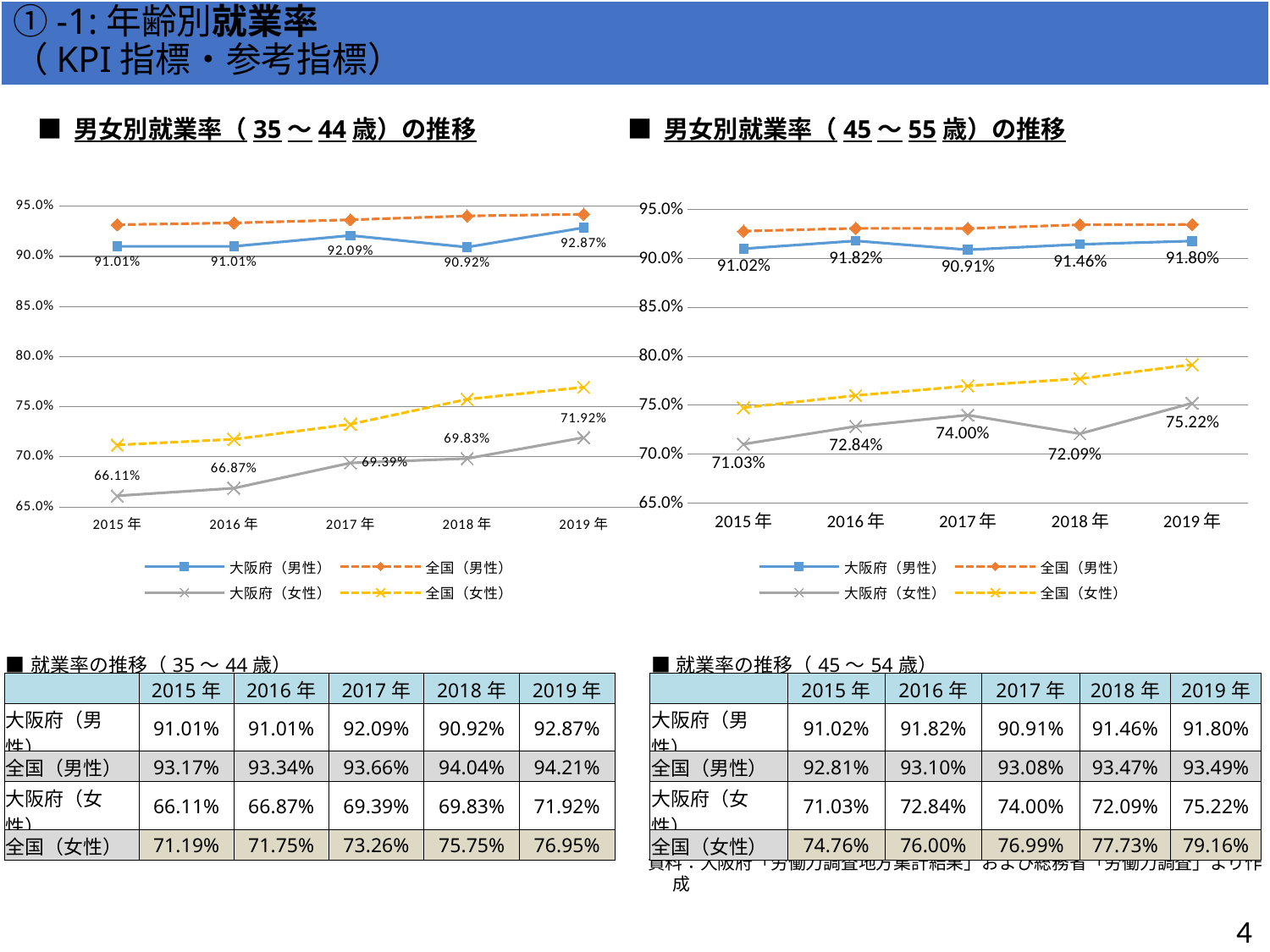
How many series does the legend of the right chart (男女別就業率（45～55歳）の推移) list? 4 In the left chart (男女別就業率（35～44歳）の推移), what is the difference between the 大阪府（女性） values in 2019年 and 2015年? 5.81% In the left chart (男女別就業率（35～44歳）の推移), which year has the lowest value for 大阪府（女性）? 2015年 In the left chart (男女別就業率（35～44歳）の推移), what is the value for 大阪府（男性） in 2019年? 92.87% What kind of chart is the left chart (男女別就業率（35～44歳）の推移)? line chart In the left chart (男女別就業率（35～44歳）の推移), is the value for 全国（女性） in 2019年 greater or less than 75.0%? greater In the right chart (男女別就業率（45～55歳）の推移), what is the value for 大阪府（男性） in 2016年? 91.82% In the right chart (男女別就業率（45～55歳）の推移), which year has the highest value for 大阪府（女性）? 2019年 In the right chart (男女別就業率（45～55歳）の推移), which is larger, the 大阪府（女性） value in 2016年 or in 2018年? 2016年 In the left chart (男女別就業率（35～44歳）の推移), does the 全国（女性） series rise or fall from 2015年 to 2019年? rise In the left chart (男女別就業率（35～44歳）の推移), what is the value for 大阪府（女性） in 2015年? 66.11% In the right chart (男女別就業率（45～55歳）の推移), what is the value for 大阪府（女性） in 2017年? 74.00%